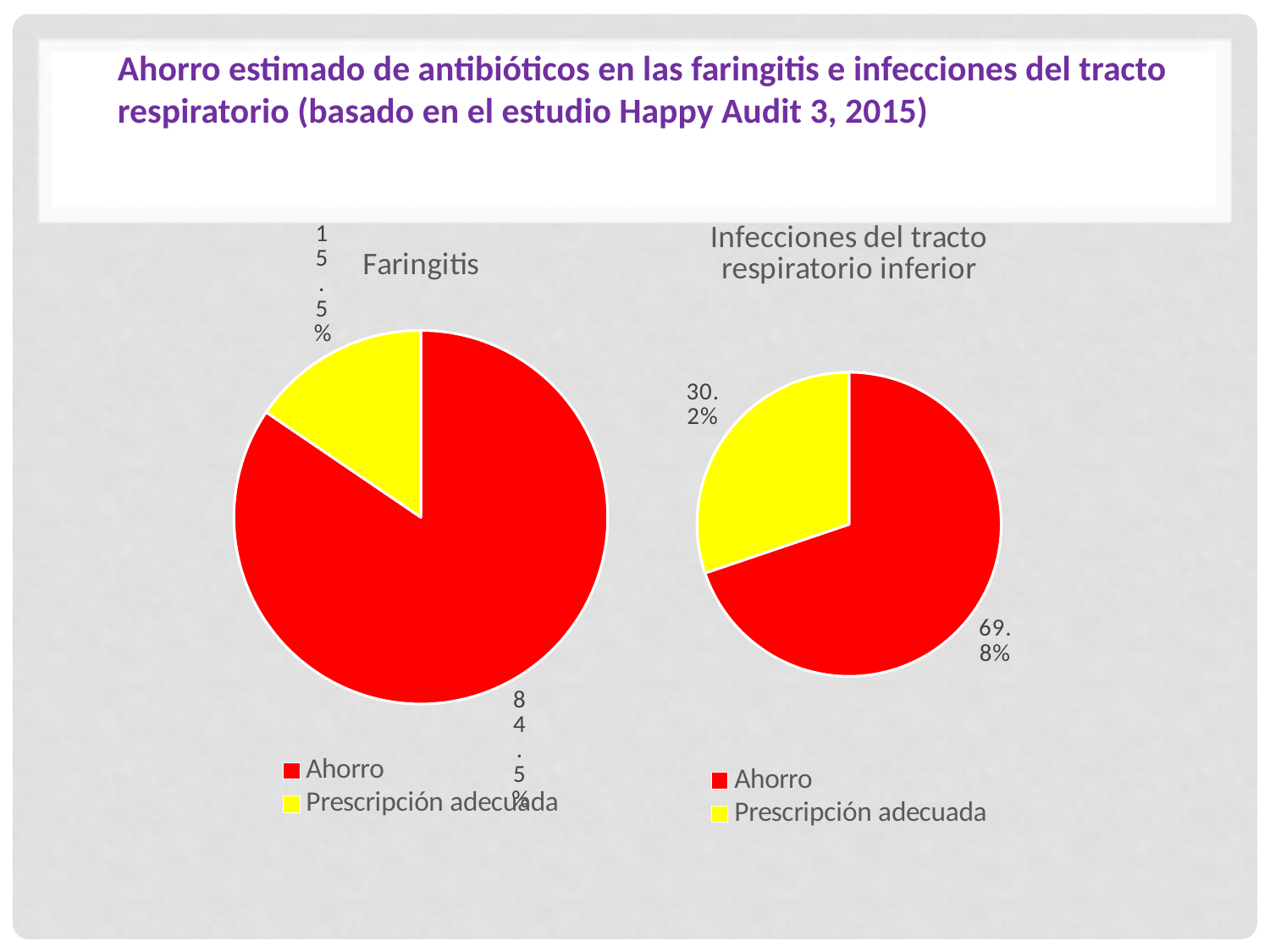
In the Infecciones del tracto respiratorio inferior chart, what is the difference between the Ahorro and Prescripción adecuada percentages? 39.6% In the Faringitis chart, what is the difference between the Ahorro and Prescripción adecuada percentages? 69.0% In the Faringitis chart, what percentage is shown for Prescripción adecuada? 15.5% What type of chart is used for Faringitis? Pie chart In the Faringitis chart, which slice is the largest? Ahorro In the Faringitis chart, what colour represents Prescripción adecuada? Yellow In the Infecciones del tracto respiratorio inferior chart, what percentage is shown for Ahorro? 69.8% In the Infecciones del tracto respiratorio inferior chart, what percentage is shown for Prescripción adecuada? 30.2% In the Infecciones del tracto respiratorio inferior chart, which slice is the smallest? Prescripción adecuada In the Faringitis chart, what percentage is shown for Ahorro? 84.5% Is the Ahorro share larger in the Faringitis chart or in the Infecciones del tracto respiratorio inferior chart? Faringitis How many slices does the Infecciones del tracto respiratorio inferior chart have? 2